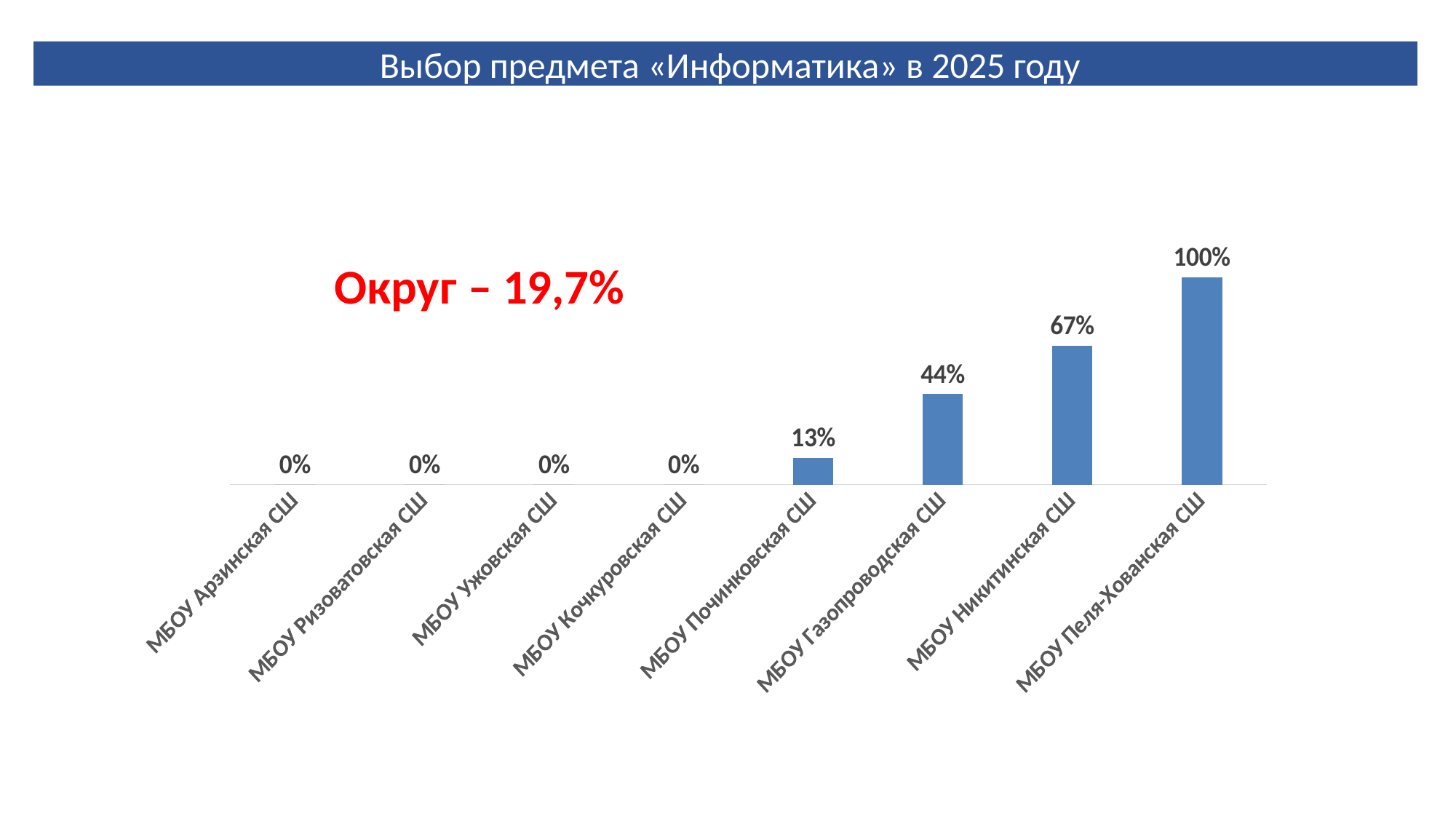
What is the value for МБОУ Пеля-Хованская СШ? 100% What is the value for МБОУ Газопроводская СШ? 44% What kind of chart is shown on the slide? bar chart Which school has the highest value? МБОУ Пеля-Хованская СШ What is the value for МБОУ Никитинская СШ? 67% What is the value for МБОУ Починковская СШ? 13% Which is larger, the value for МБОУ Газопроводская СШ or МБОУ Починковская СШ? МБОУ Газопроводская СШ What is the difference between the values for МБОУ Пеля-Хованская СШ and МБОУ Починковская СШ? 87% What is the difference between the values for МБОУ Никитинская СШ and МБОУ Газопроводская СШ? 23% What is the value for the district (Округ) shown in red text on the slide? 19,7% What is the value for МБОУ Арзинская СШ? 0% How many schools are shown on the chart? 8